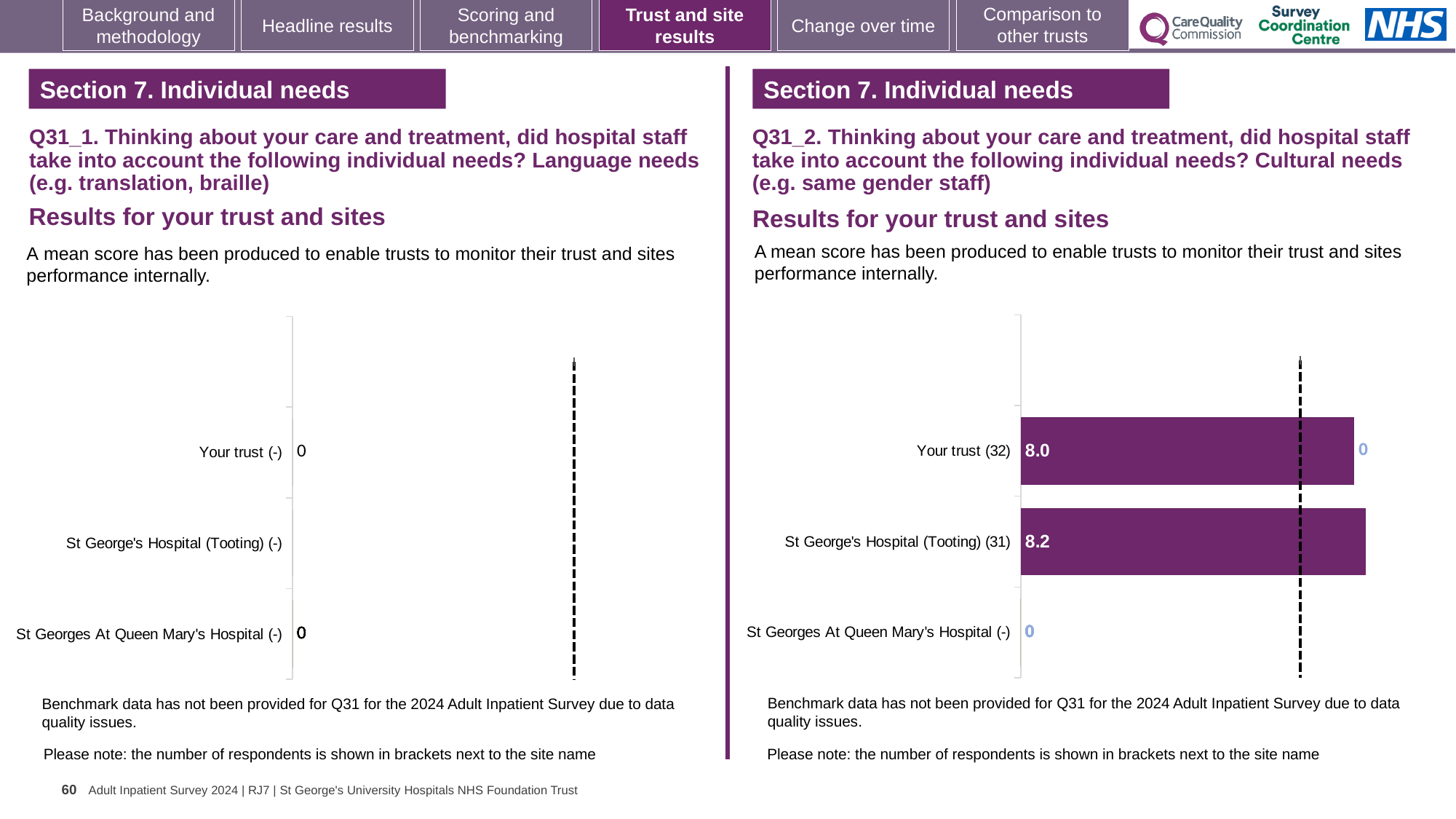
In the Q31_2 chart on the right, which has the larger score: Your trust or St George's Hospital (Tooting)? St George's Hospital (Tooting) In the Q31_2 chart on the right, how many respondents are shown in brackets for St George's Hospital (Tooting)? 31 In the Q31_2 chart on the right, which category has the highest mean score? St George's Hospital (Tooting) In the Q31_2 chart on the right, what is the mean score for Your trust? 8.0 In the Q31_1 chart on the left, what value is shown for Your trust? 0 What kind of chart is used for the Q31_2 results on the right? Bar chart In the Q31_2 chart on the right, how many respondents are shown in brackets for Your trust? 32 In the Q31_2 chart on the right, what is the mean score for St George's Hospital (Tooting)? 8.2 How many categories are listed on the y axis of the Q31_2 chart on the right? 3 In the Q31_2 chart on the right, what is the difference between the scores for St George's Hospital (Tooting) and Your trust? 0.2 How many categories are listed on the y axis of the Q31_1 chart on the left? 3